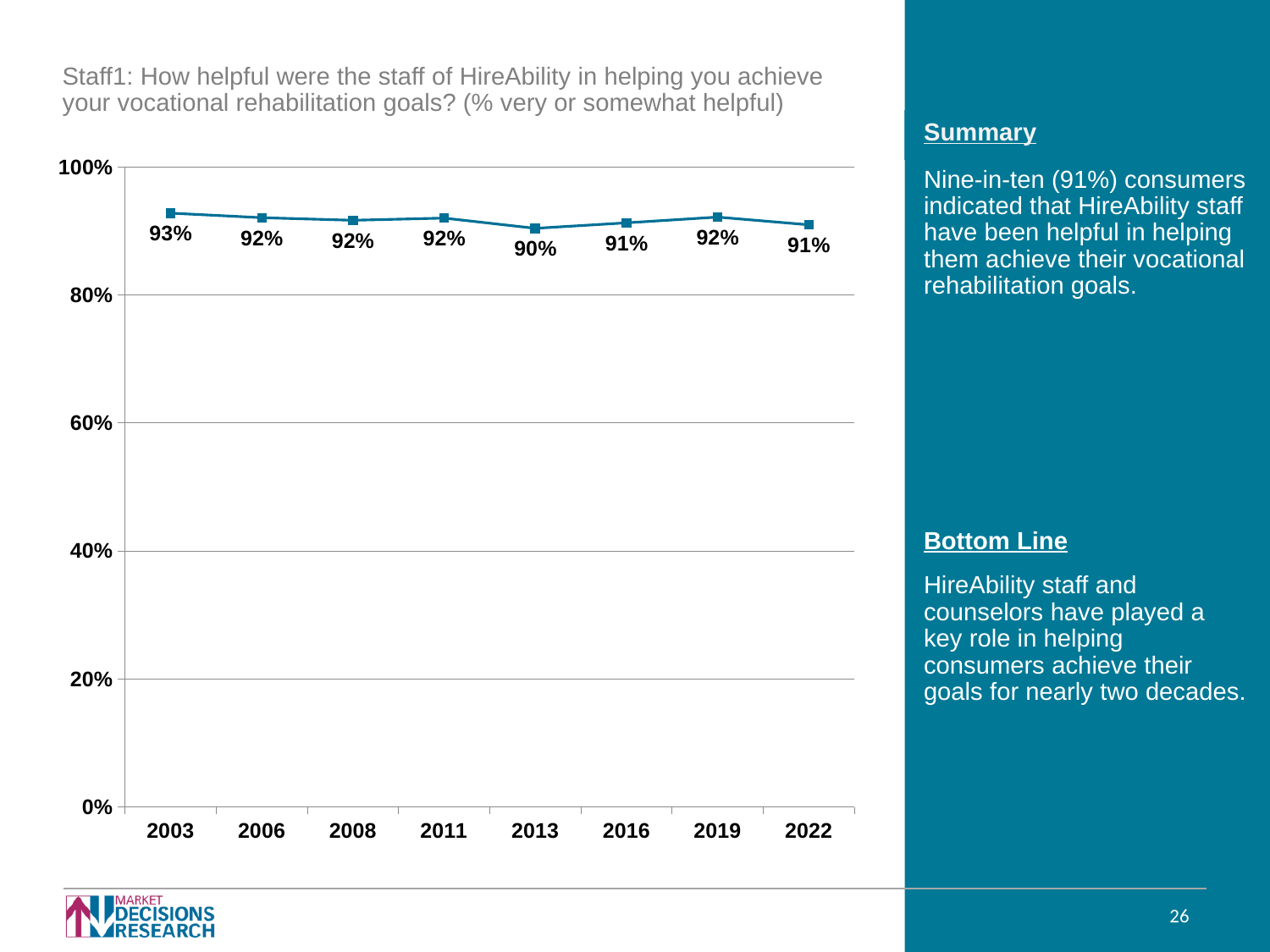
What percentage of consumers said HireAbility staff were very or somewhat helpful in 2003? 93% Which year has the lowest value on the chart? 2013 What is the difference between the 2003 value and the 2013 value? 3% How many years are plotted on the chart? 8 Is the value for 2016 greater or less than 80%? greater Does the value change from 2019 to 2022 rise or fall? Fall What kind of chart is shown on the slide? Line chart What is the value shown for 2013? 90% Which year has the highest value on the chart? 2003 What is the value shown for 2022? 91% Which year has the larger value, 2019 or 2022? 2019 What is the highest value labelled on the vertical axis? 100%